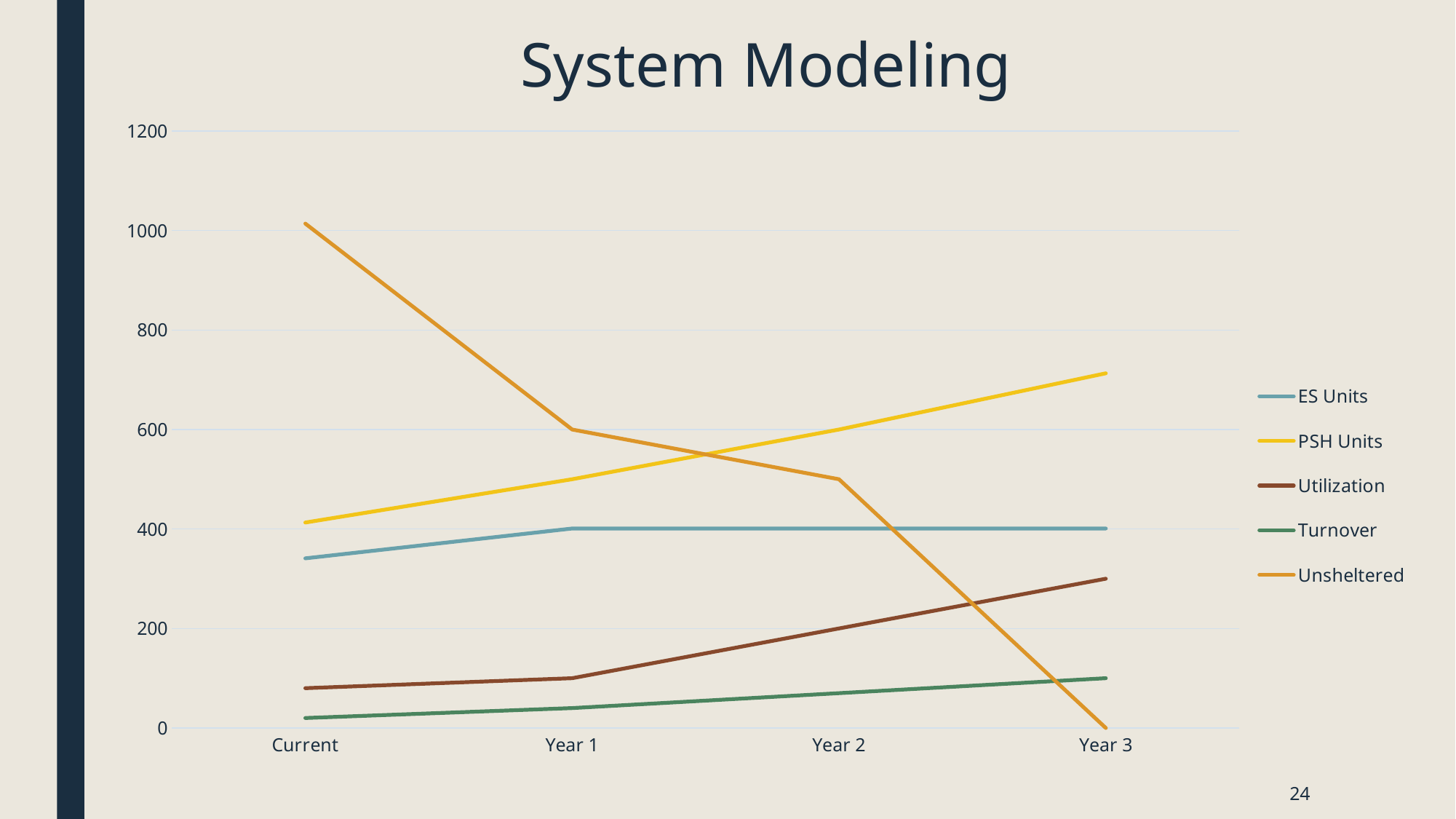
Is the value for PSH Units at Year 3 greater or less than 600? greater At Year 3, which is larger: PSH Units or Utilization? PSH Units Does the PSH Units line rise or fall from Current to Year 3? rise Is the value for Unsheltered at Current greater or less than 1000? greater How many series does the legend list? 5 Does the Unsheltered line rise or fall from Current to Year 3? fall Which series has the highest value at Current? Unsheltered What kind of chart is shown on the slide? line chart Which series has the lowest value at Current? Turnover What is the value of Unsheltered at Year 3? 0 How many points are on the x axis? 4